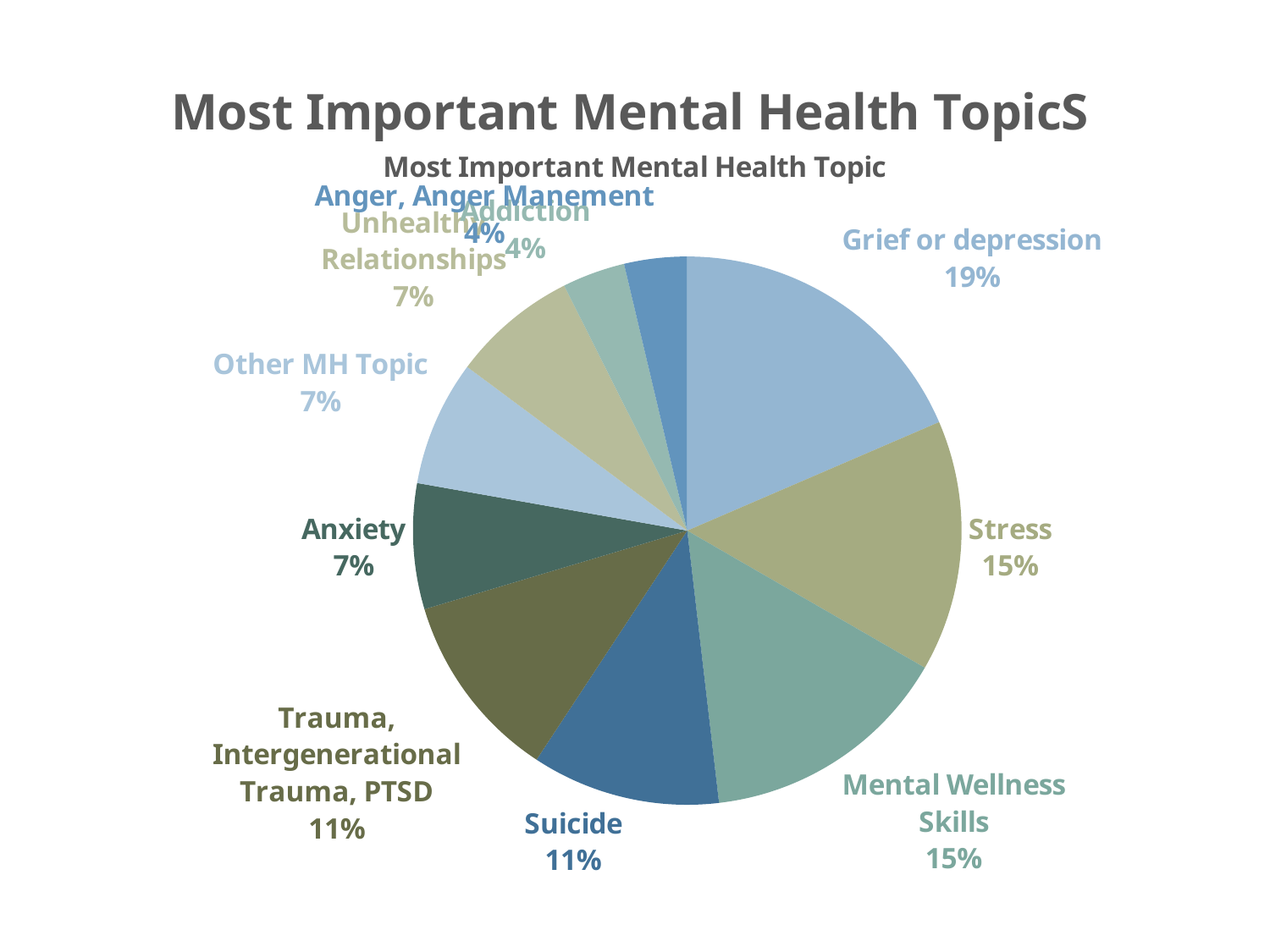
What is the value for Trauma, Intergenerational Trauma, PTSD? 11% Which topic has the largest slice of the pie? Grief or depression What is the difference in percentage points between Stress and Anxiety? 8 What percentage of the pie is Grief or depression? 19% Which is larger, the slice for Suicide or the slice for Other MH Topic? Suicide What is the difference in percentage points between Grief or depression and Mental Wellness Skills? 4 What is the value shown for Suicide? 11% How many slices does the pie chart have? 10 What percentage is labelled for Anxiety? 7% What kind of chart is shown on the slide? pie chart What share does Stress have in the pie chart? 15% What is the chart's title? Most Important Mental Health Topic